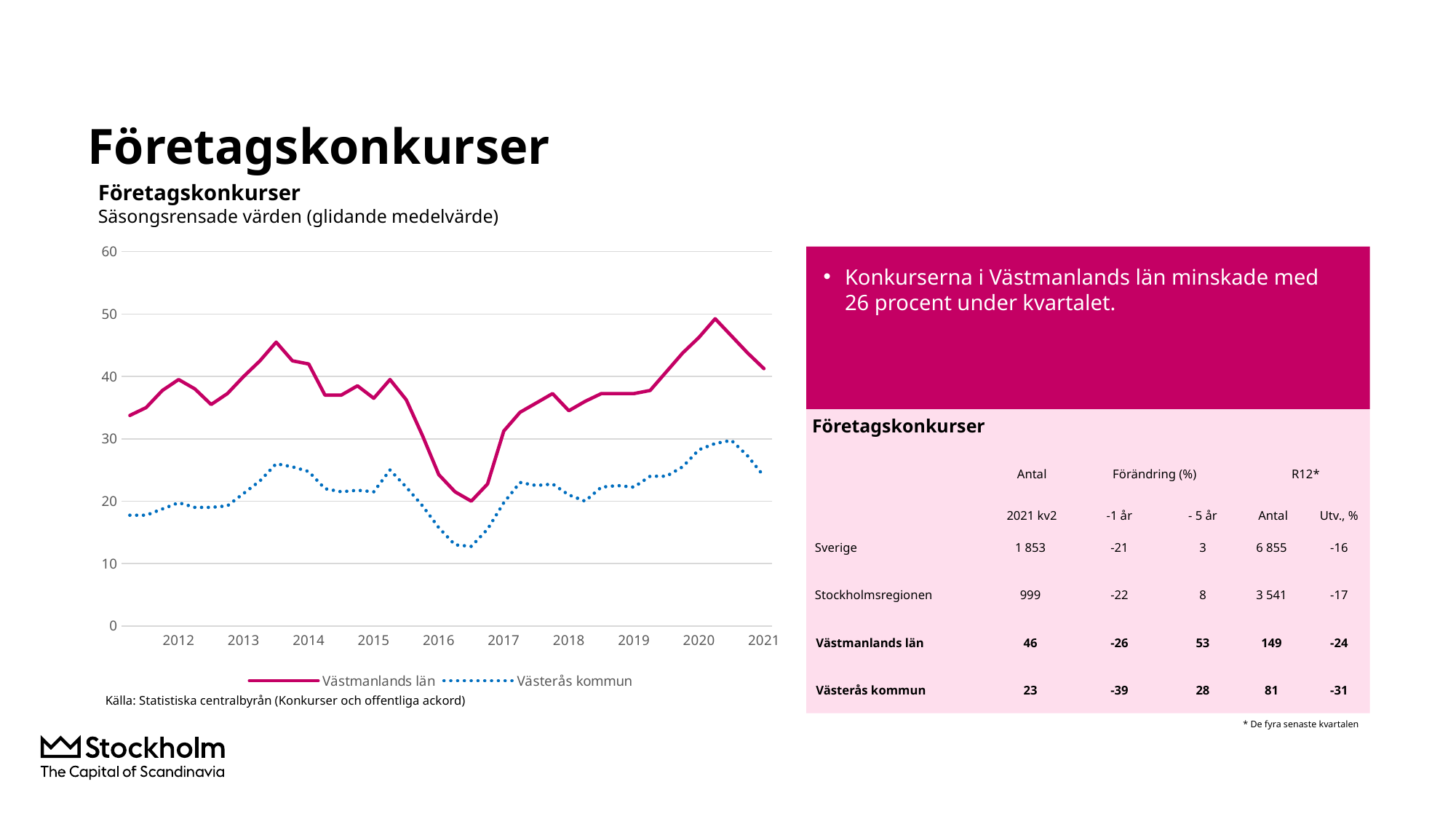
How many series does the chart legend list? 2 Does the Västmanlands län line rise or fall between 2020 and 2021? fall Around which year does the Västmanlands län line reach its highest value? 2020 How many year labels are shown on the x axis of the chart? 10 What is the subtitle of the chart below 'Företagskonkurser'? Säsongsrensade värden (glidande medelvärde) Which two series are shown in the chart legend? Västmanlands län and Västerås kommun Is the value of the Västmanlands län line at the start of 2012 greater or less than 30? greater Which series has the higher value around 2020, Västmanlands län or Västerås kommun? Västmanlands län Is the lowest value of the Västerås kommun line around 2016 greater or less than 20? less Is the peak value of the Västmanlands län line around 2020 greater or less than 40? greater What kind of chart is shown on the slide? line chart Around which year does the Västerås kommun line reach its lowest value? 2016